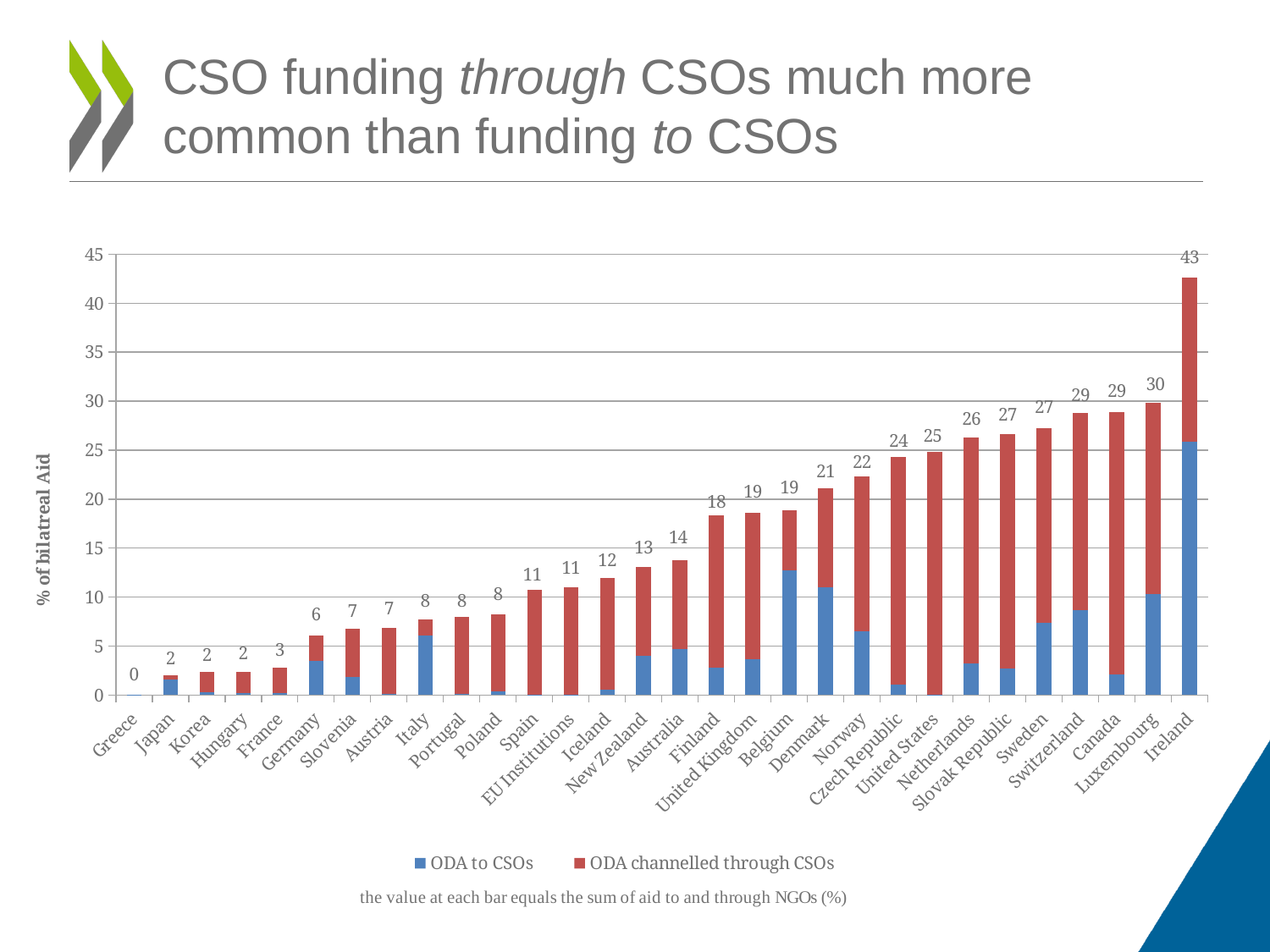
Is the ODA to CSOs value for Belgium greater or less than 10? greater Do the total values rise or fall moving from left to right along the x axis? Rise What is the difference between the total values for Ireland and Luxembourg? 13 How many series does the legend list? 2 What is the total value shown for Ireland? 43 What is the total value shown for the United Kingdom? 19 Which country has the highest total value in the chart? Ireland What is the total of the stacked bar for the Netherlands? 26 Which has a larger total value, Norway or Finland? Norway How many countries or institutions are shown on the x axis? 30 Which country has the lowest total value in the chart? Greece What kind of chart is shown on the slide? Stacked bar chart